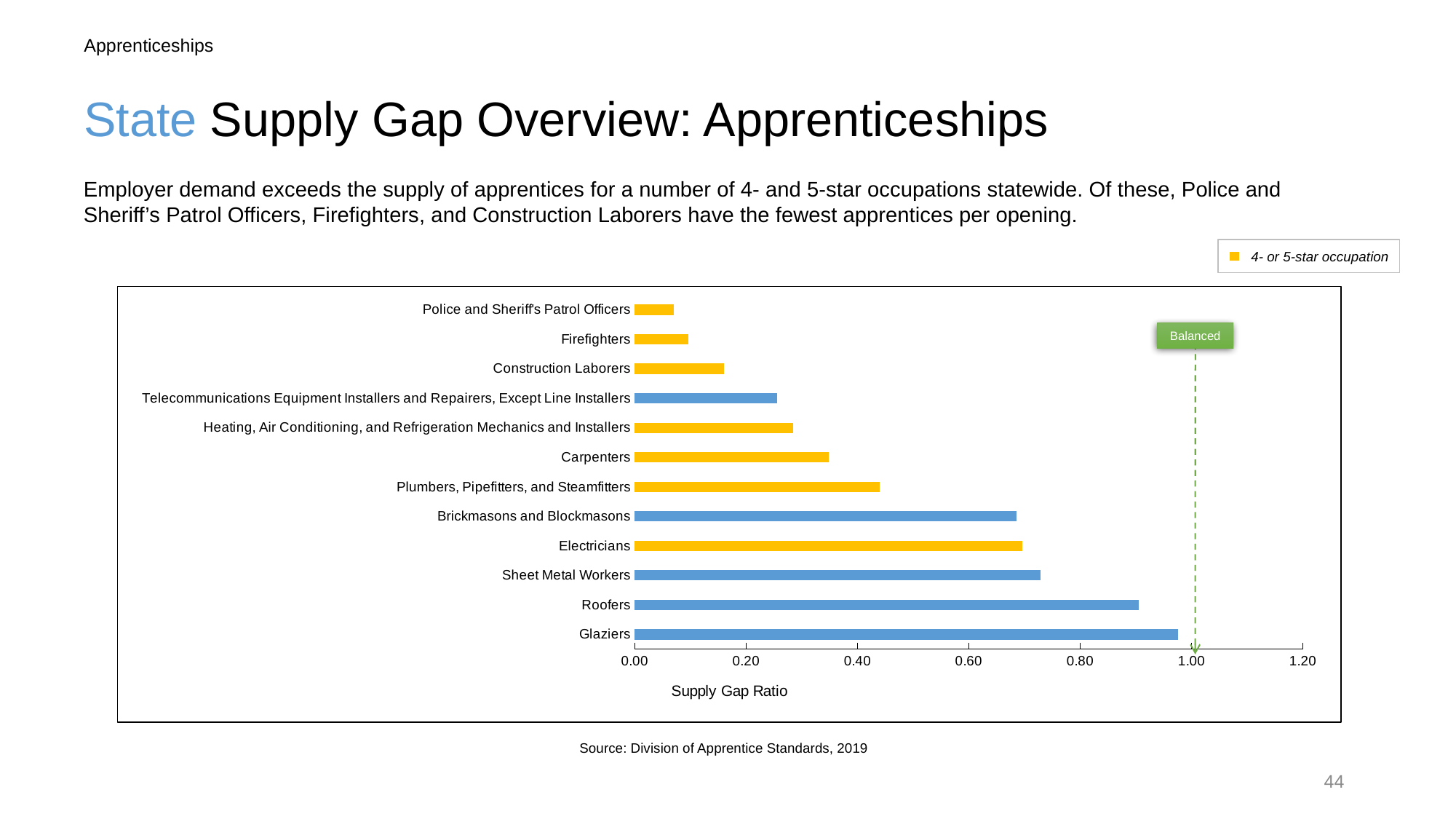
Is the supply gap ratio for Glaziers greater or less than 0.80? greater Is the supply gap ratio for Electricians greater or less than 0.60? greater What kind of chart is shown on the slide? Bar chart Is the supply gap ratio for Sheet Metal Workers greater or less than 0.80? less At what value on the axis is the dashed 'Balanced' line drawn? 1.00 Which occupation has the lowest supply gap ratio? Police and Sheriff's Patrol Officers What is the title of the horizontal axis? Supply Gap Ratio Which has a larger supply gap ratio, Roofers or Carpenters? Roofers Which has a larger supply gap ratio, Sheet Metal Workers or Plumbers, Pipefitters, and Steamfitters? Sheet Metal Workers How many occupations are plotted in the chart? 12 Which occupation has the highest supply gap ratio? Glaziers